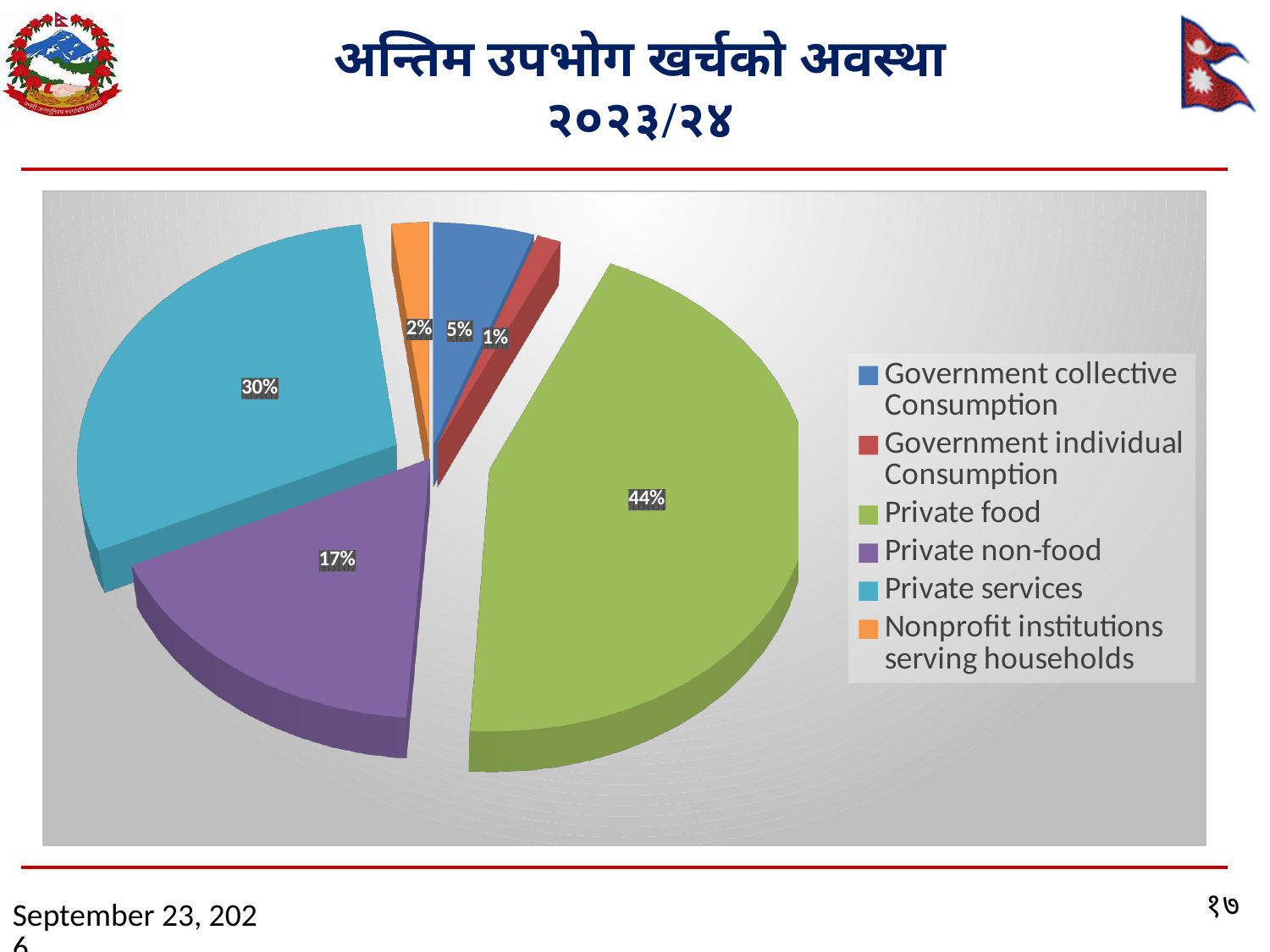
What is the value shown for Private non-food? 17% What share of the pie does Private services account for? 30% How many categories does the pie chart show? 6 What is the value shown for Government collective Consumption? 5% What is the value shown for Nonprofit institutions serving households? 2% What is the difference between the Private food share and the Private services share? 14% What share of the pie does Private food account for? 44% Which is larger, the share for Private non-food or the share for Government collective Consumption? Private non-food Which category has the smallest slice of the pie? Government individual Consumption What kind of chart is shown on the slide? Pie chart Which category has the largest slice of the pie? Private food What colour is the Private services slice in the legend? Light blue